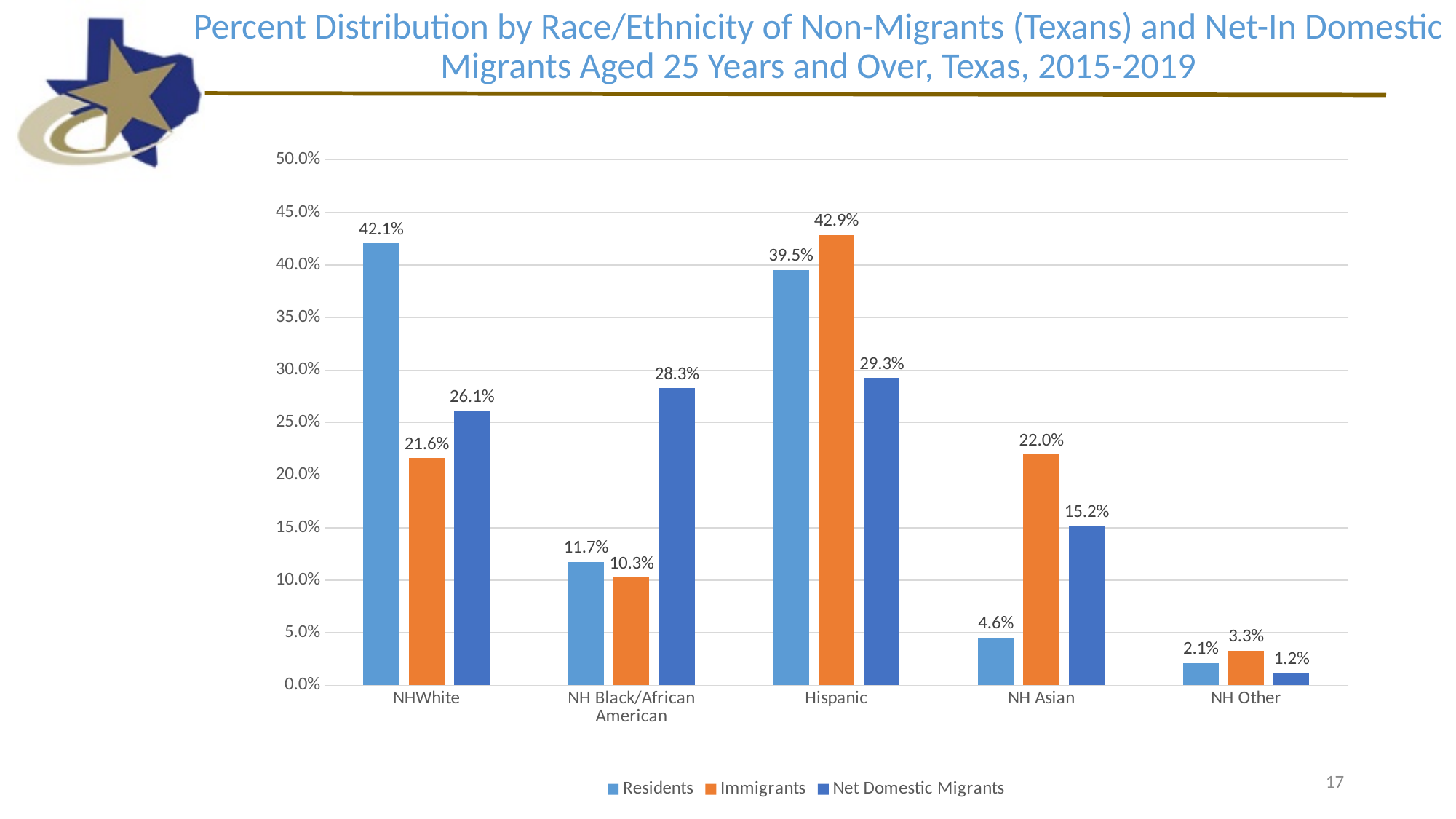
What is the difference between the Residents and Immigrants values for NHWhite? 20.5% Which category has the highest Immigrants value? Hispanic What is the Residents value for NHWhite? 42.1% How many series does the legend list? 3 What is the Immigrants value for NH Asian? 22.0% Which is larger for Hispanic: the Residents value or the Immigrants value? Immigrants How many race/ethnicity categories are shown on the x axis? 5 What kind of chart is shown on the slide? bar chart What is the Net Domestic Migrants value for NH Black/African American? 28.3% Which series is shown in orange in the legend? Immigrants Is the Net Domestic Migrants value for NH Asian greater or less than 20.0%? less Which category has the lowest Net Domestic Migrants value? NH Other